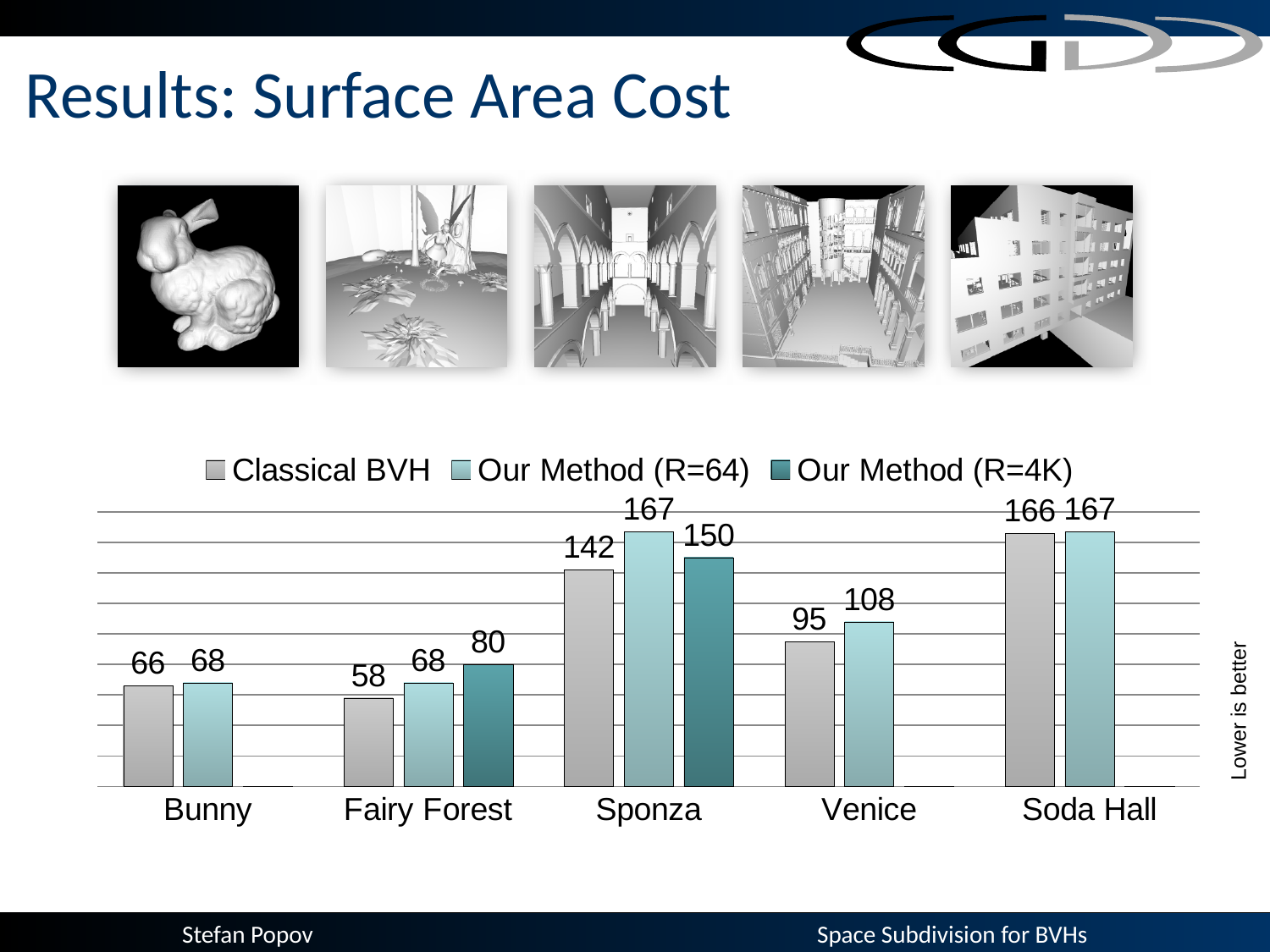
What is the difference between the Our Method (R=64) and Classical BVH values for Sponza? 25 What is the Classical BVH value for Sponza? 142 What kind of chart is shown on the slide? Bar chart What is the Our Method (R=4K) value for Fairy Forest? 80 What is the difference between the Our Method (R=4K) and Classical BVH values for Fairy Forest? 22 Which category has the highest Classical BVH value? Soda Hall What does the text on the right side of the chart say? Lower is better Which category has the lowest Classical BVH value? Fairy Forest How many series does the legend list? 3 What is the Our Method (R=64) value for Venice? 108 How many categories are shown on the x axis? 5 For Sponza, which is larger: the Our Method (R=64) value or the Our Method (R=4K) value? Our Method (R=64)